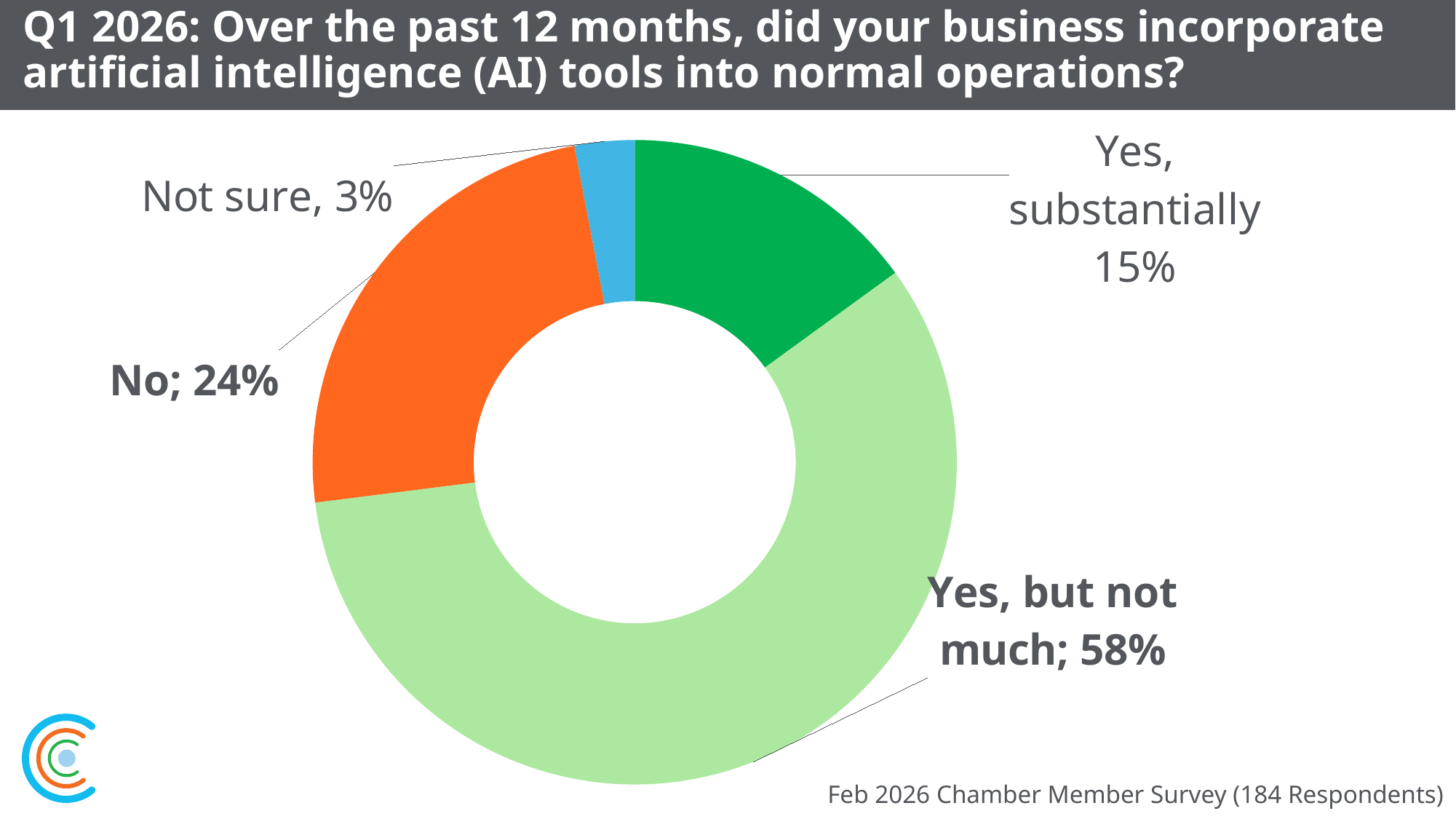
What share of respondents answered "Yes, but not much"? 58% Which is larger: the share for "No" or the share for "Yes, substantially"? No What kind of chart is shown on the slide? Doughnut (pie) chart How many respondents does the survey note at the bottom of the slide cite? 184 How many response categories are shown in the chart? 4 What is the difference in percentage points between "Yes, but not much" and "No"? 34 What is the difference in percentage points between "No" and "Yes, substantially"? 9 Which response has the largest share of the chart? Yes, but not much Which response has the smallest share of the chart? Not sure What share of respondents answered "Not sure"? 3% What share of respondents answered "No"? 24% What share of respondents answered "Yes, substantially"? 15%